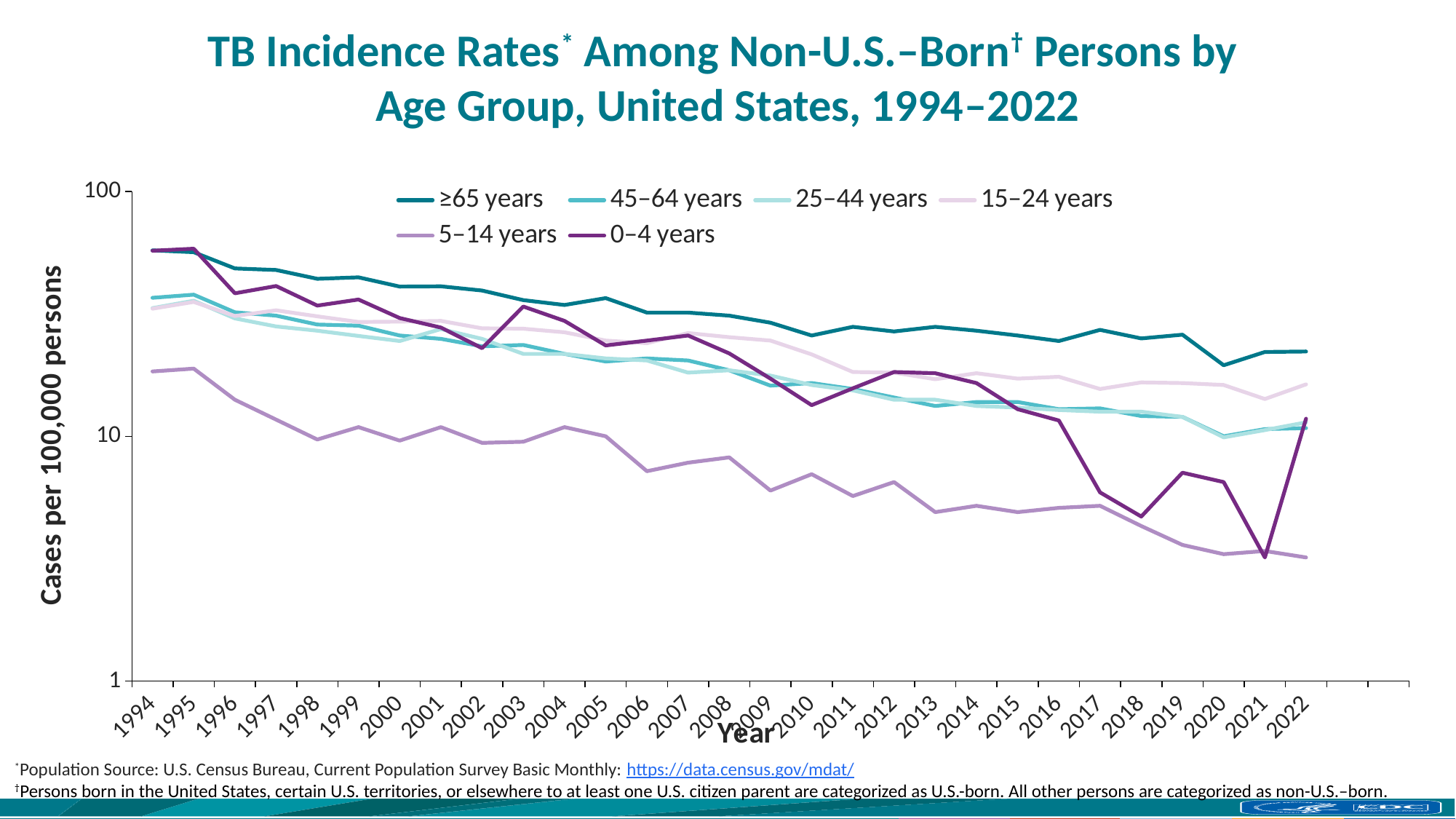
Is the value for 5–14 years in 2022 greater or less than 10? less How many age-group series does the legend list? 6 Which age group has the lowest TB incidence rate in 2022? 5–14 years What is the label on the y axis? Cases per 100,000 persons Which age group has the highest TB incidence rate in 2022? ≥65 years In 2010, which is larger: the rate for ≥65 years or the rate for 0–4 years? ≥65 years Is the value for ≥65 years in 2022 greater or less than 10? greater How many years are plotted along the x axis? 29 What kind of chart is shown on the slide? Line chart Which age group has the lowest TB incidence rate in 2010? 5–14 years Does the TB incidence rate for ≥65 years generally rise or fall from 1994 to 2022? Fall Is the value for 0–4 years in 2021 greater or less than 10? less